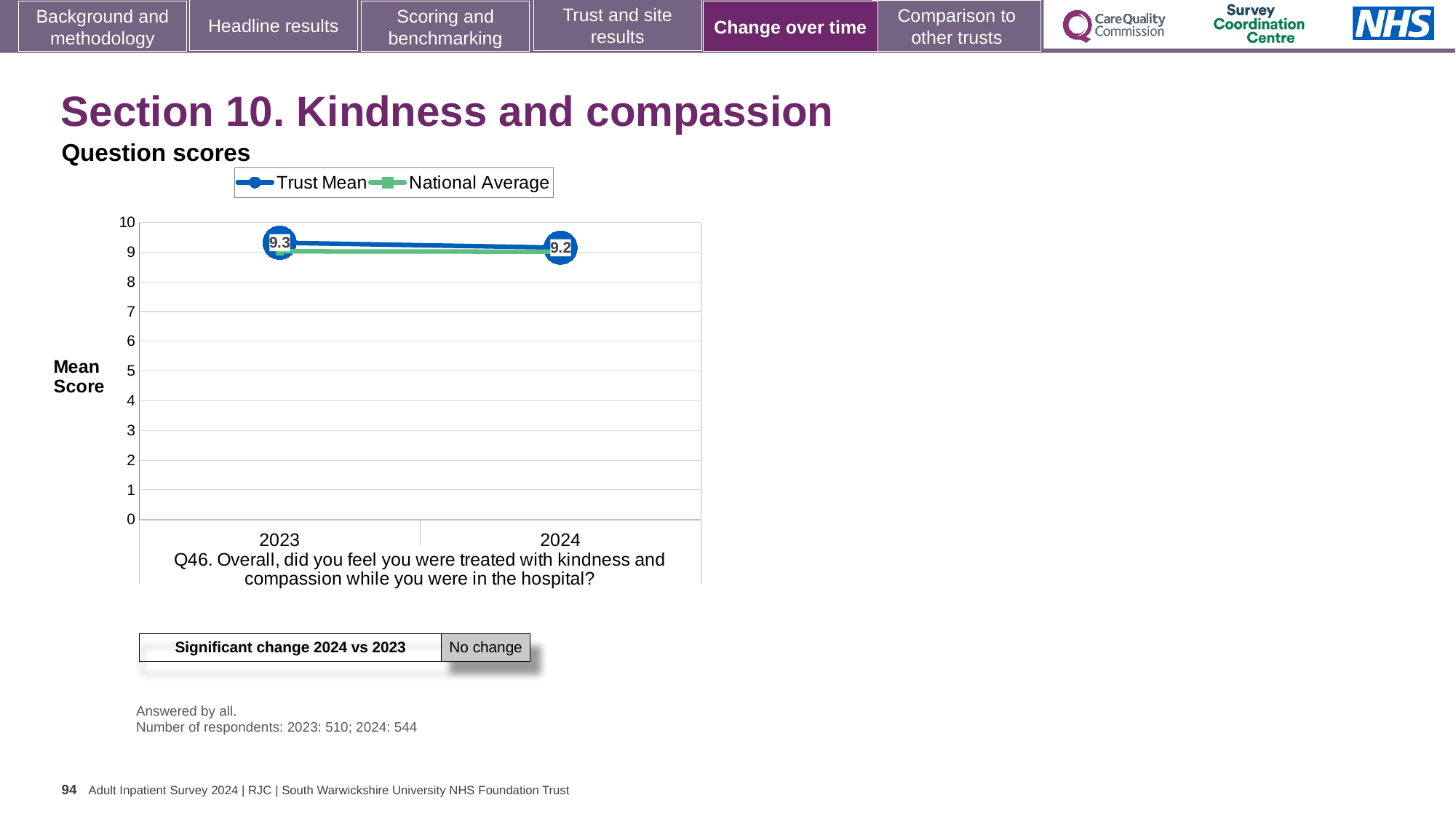
What is the Trust Mean score for 2023? 9.3 Does the Trust Mean rise or fall from 2023 to 2024? Fall How many years are shown on the x axis of the chart? 2 What is the label on the y axis of the chart? Mean Score What is the Trust Mean score for 2024? 9.2 What kind of chart is shown on the slide? Line chart How many series does the chart legend list? 2 In which year is the Trust Mean score lower? 2024 Is the National Average value for 2024 greater or less than 8? greater In which year is the Trust Mean score higher? 2023 Which is larger, the Trust Mean for 2023 or the Trust Mean for 2024? 2023 What is the difference between the Trust Mean scores for 2023 and 2024? 0.1